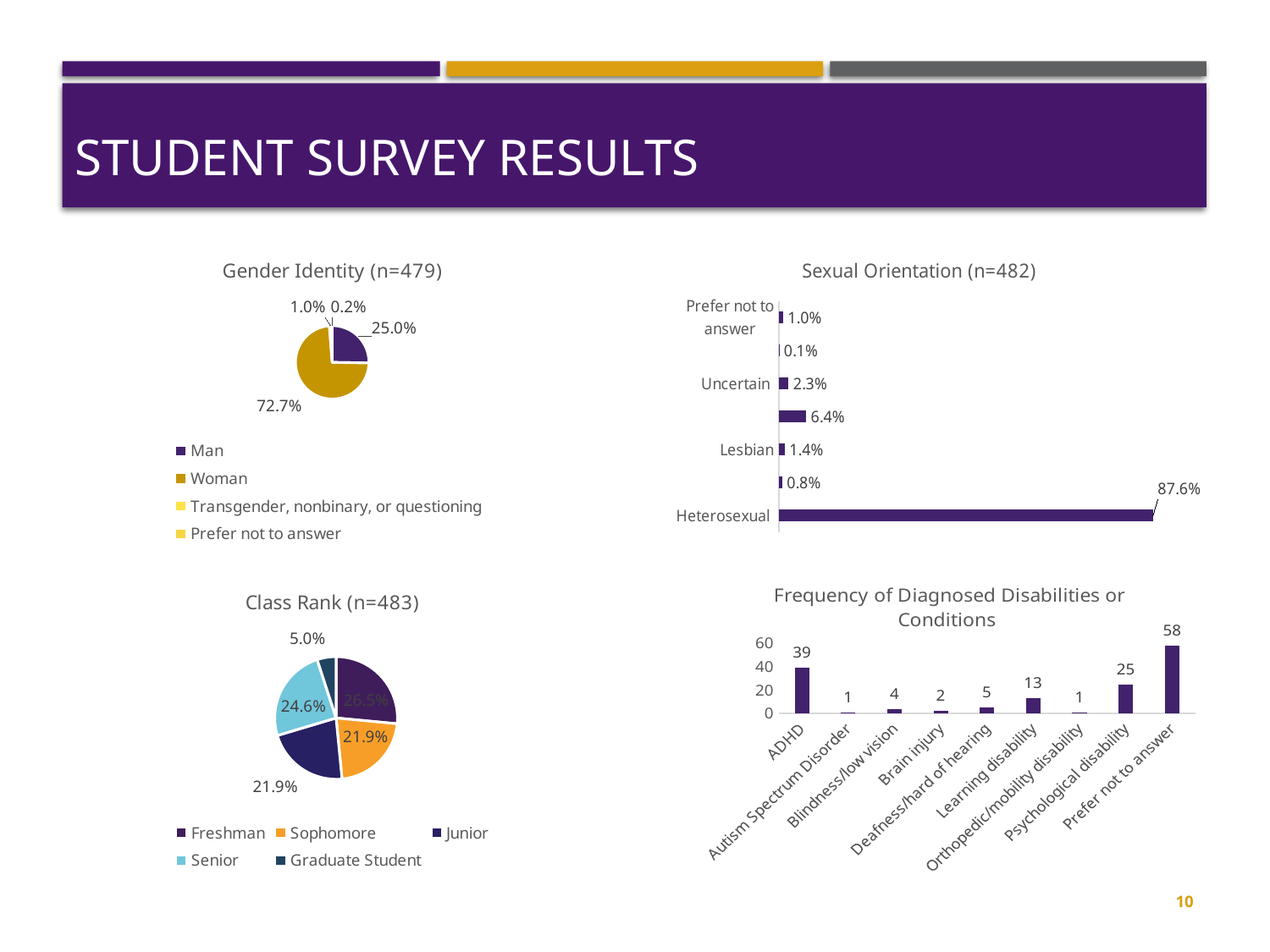
In the Gender Identity (n=479) chart, what percentage of respondents identified as Man? 25.0% In the Frequency of Diagnosed Disabilities or Conditions chart, what is the value for Psychological disability? 25 In the Class Rank (n=483) chart, which class rank has the smallest share? Graduate Student In the Frequency of Diagnosed Disabilities or Conditions chart, what is the difference between Prefer not to answer and ADHD? 19 In the Sexual Orientation (n=482) chart, what is the value for Heterosexual? 87.6% In the Sexual Orientation (n=482) chart, what is the value for Uncertain? 2.3% In the Class Rank (n=483) chart, what percentage of respondents are Senior? 24.6% What kind of chart is the Gender Identity (n=479) chart? Pie chart How many categories are shown in the Frequency of Diagnosed Disabilities or Conditions chart? 9 In the Sexual Orientation (n=482) chart, which category has the highest value? Heterosexual How many entries does the legend of the Class Rank (n=483) chart list? 5 In the Gender Identity (n=479) chart, what percentage of respondents identified as Woman? 72.7%